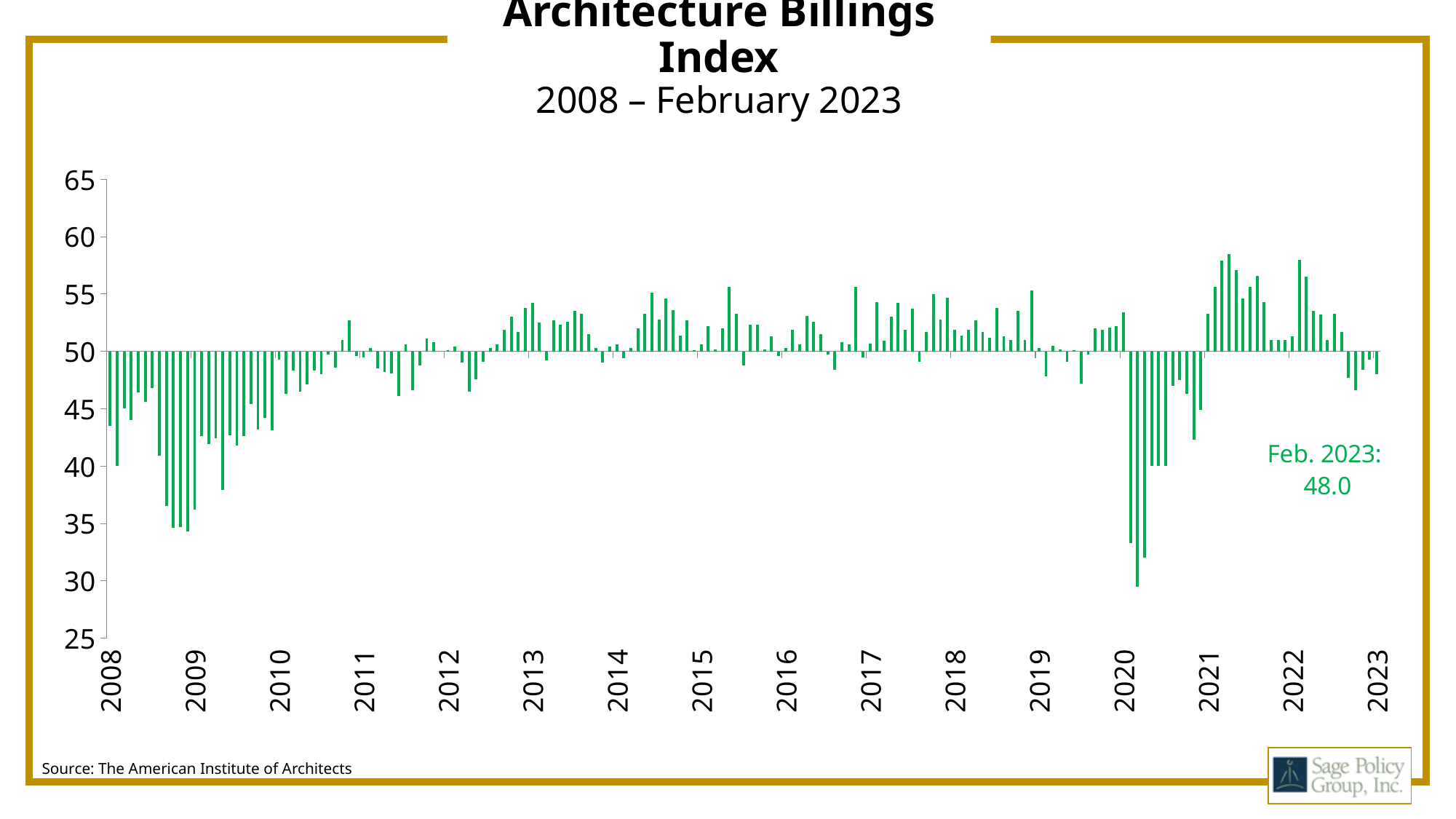
Is the highest value in 2021 greater or less than 55? greater Is the February 2023 value of the Architecture Billings Index greater or less than 50? less Do the values of the Architecture Billings Index rise or fall from the 2020 low to the 2021 peak? rise Which is higher: the peak value in 2021 or the peak value in 2014? 2021 What is the value of the Architecture Billings Index for February 2023, as labelled on the chart? 48.0 What kind of chart is used to show the Architecture Billings Index? Bar chart How many year labels are shown on the x axis of the chart? 16 What source is cited for the Architecture Billings Index chart? The American Institute of Architects Which is lower: the lowest value in 2009 or the lowest value in 2020? 2020 In which year does the Architecture Billings Index reach its lowest value on the chart? 2020 Is the lowest value in 2020 greater or less than 35? less In which year does the Architecture Billings Index reach its highest value on the chart? 2021